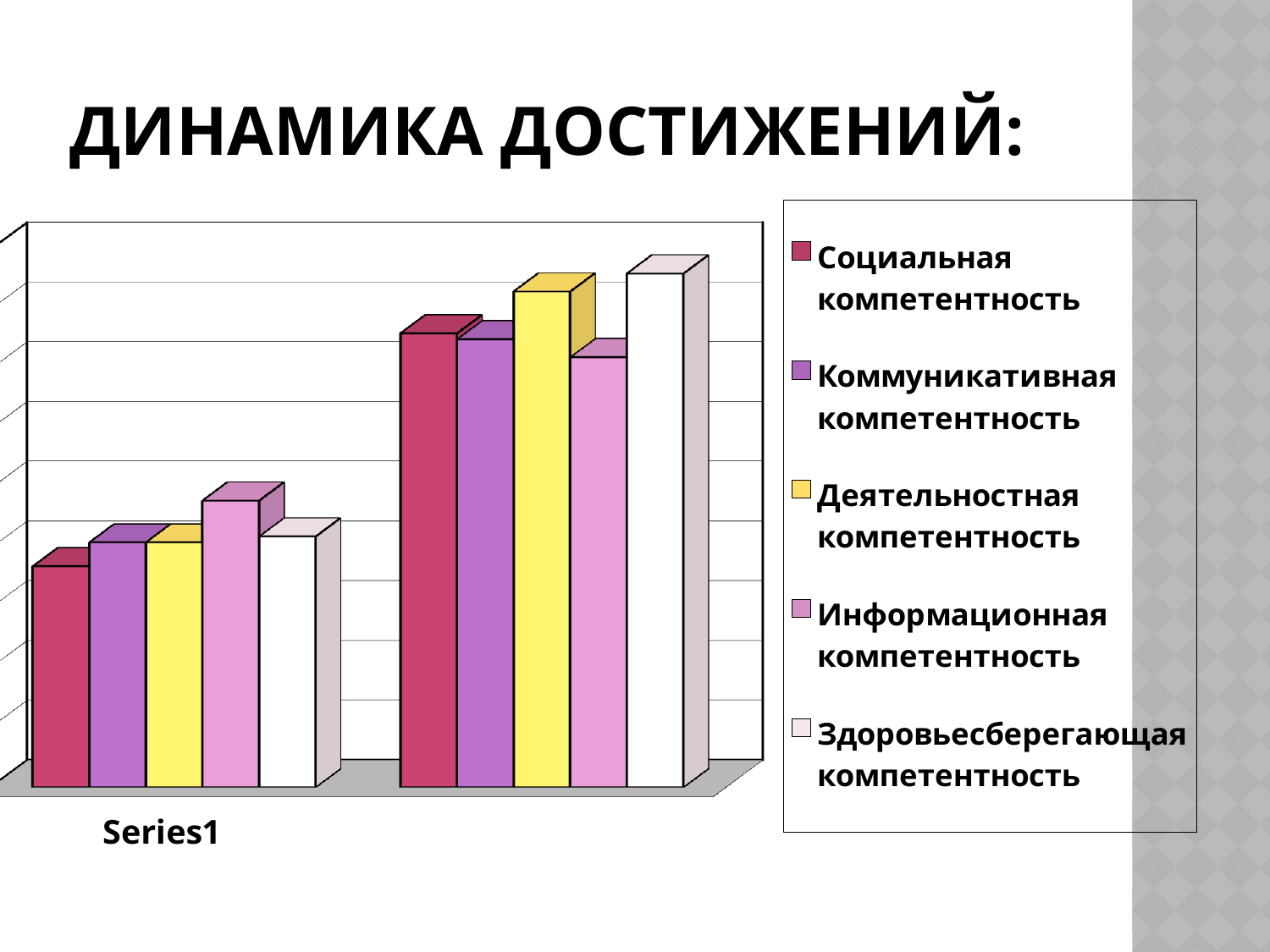
How many groups of bars are plotted on the chart? 2 In the right-hand (second) group of bars, which is larger: Здоровьесберегающая компетентность or Социальная компетентность? Здоровьесберегающая компетентность What kind of chart is shown on the slide? bar chart Which colour represents Деятельностная компетентность in the legend? yellow Does the bar for Здоровьесберегающая компетентность rise or fall from the first group to the second group? rise In the group labelled Series1, which competence has the highest bar? Информационная компетентность In the group labelled Series1, which is larger: Информационная компетентность or Социальная компетентность? Информационная компетентность What is the title of the slide above the chart? ДИНАМИКА ДОСТИЖЕНИЙ: In the group labelled Series1, which competence has the lowest bar? Социальная компетентность Does the bar for Социальная компетентность rise or fall from the first group to the second group? rise How many series does the legend list? 5 In the right-hand (second) group of bars, which is larger: Деятельностная компетентность or Информационная компетентность? Деятельностная компетентность